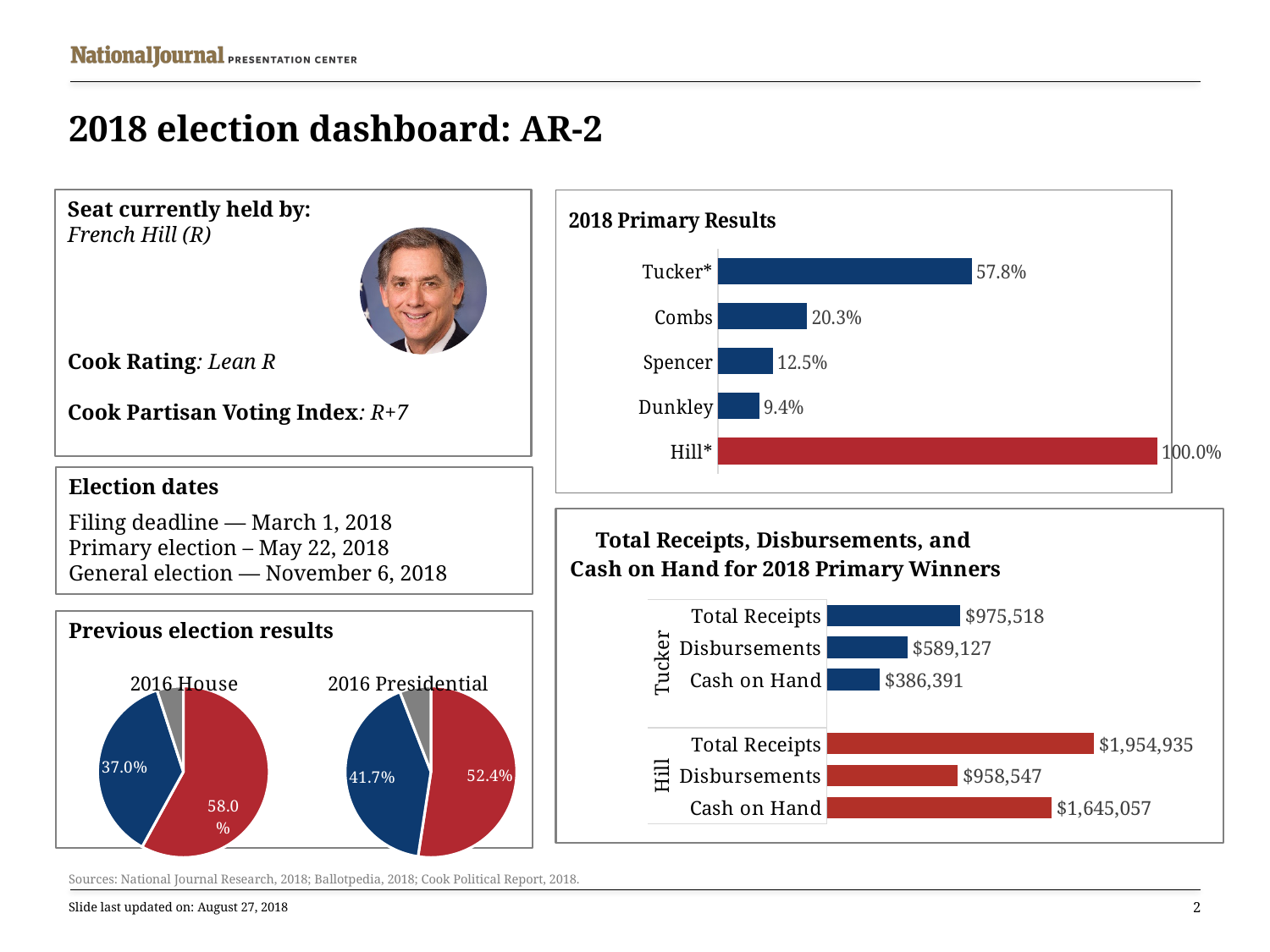
In the 2018 Primary Results chart, what percentage did Dunkley receive? 9.4% What kind of chart is the 2018 Primary Results chart? Bar chart In the 2018 Primary Results chart, which candidate has the lowest percentage? Dunkley In the Total Receipts, Disbursements, and Cash on Hand chart, who has the larger Disbursements, Tucker or Hill? Hill In the Total Receipts, Disbursements, and Cash on Hand chart, what is Tucker's Cash on Hand? $386,391 In the Total Receipts, Disbursements, and Cash on Hand chart, how much greater are Hill's Total Receipts than Tucker's Total Receipts? $979,417 In the Total Receipts, Disbursements, and Cash on Hand chart, what is Hill's Total Receipts value? $1,954,935 In the 2016 Presidential pie chart, what is the share of the blue slice? 41.7% How many candidates are shown in the 2018 Primary Results chart? 5 In the 2016 House pie chart, what is the share of the red slice? 58.0% In the 2018 Primary Results chart, what percentage did Tucker* receive? 57.8% In the 2018 Primary Results chart, what is the difference in percentage points between Tucker* and Combs? 37.5